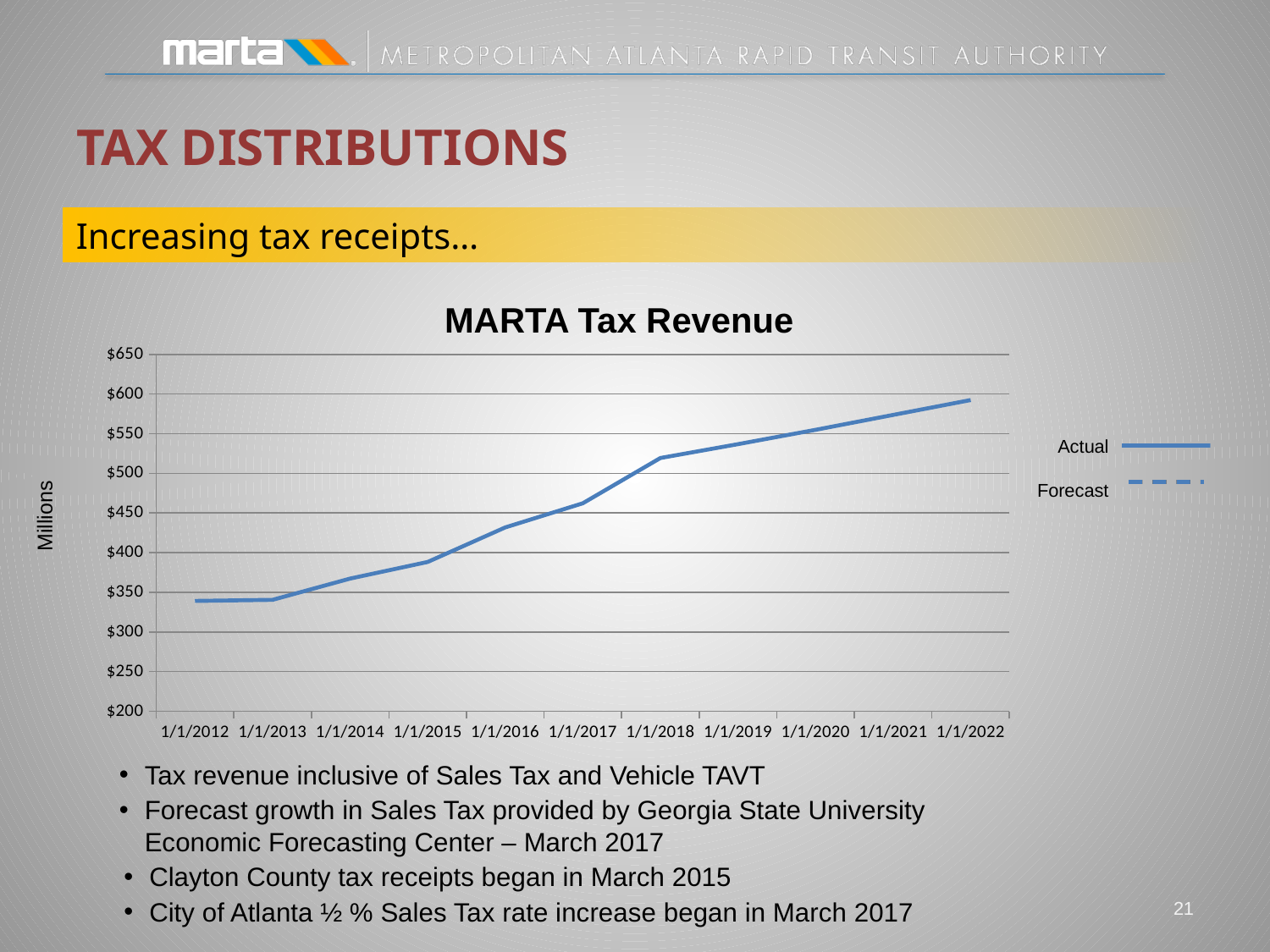
Is the value for 1/1/2018 greater or less than $500? greater Is the value for 1/1/2012 greater or less than $300? greater What is the title of the chart? MARTA Tax Revenue Is the value for 1/1/2015 greater or less than $400? less What kind of chart is shown on the slide? line chart Which is larger, the value for 1/1/2016 or the value for 1/1/2019? 1/1/2019 Which date has the highest value in the chart? 1/1/2022 How many dates are shown along the x axis of the chart? 11 How many series does the chart legend list? 2 Do the values in the chart rise or fall from 1/1/2012 to 1/1/2022? rise What label is shown on the vertical axis of the chart? Millions